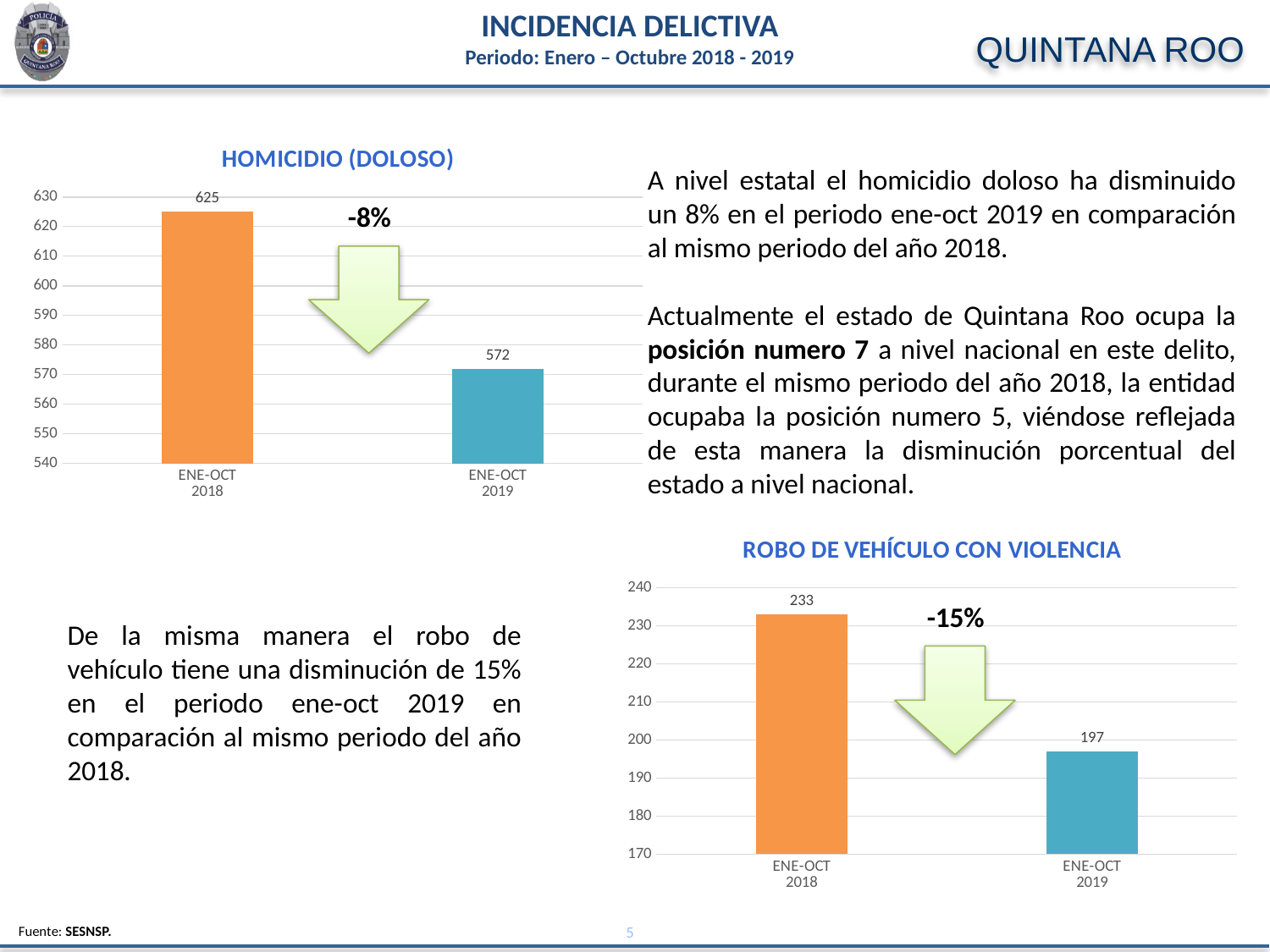
In the ROBO DE VEHÍCULO CON VIOLENCIA chart, what is the value for ENE-OCT 2019? 197 In the ROBO DE VEHÍCULO CON VIOLENCIA chart, which period has the lower value? ENE-OCT 2019 In the ROBO DE VEHÍCULO CON VIOLENCIA chart, what is the value for ENE-OCT 2018? 233 In the HOMICIDIO (DOLOSO) chart, what is the difference between the ENE-OCT 2018 and ENE-OCT 2019 values? 53 In the HOMICIDIO (DOLOSO) chart, what percentage change is shown next to the arrow? -8% In the HOMICIDIO (DOLOSO) chart, which period has the higher value? ENE-OCT 2018 In the ROBO DE VEHÍCULO CON VIOLENCIA chart, what is the difference between the ENE-OCT 2018 and ENE-OCT 2019 values? 36 How many categories are shown in the ROBO DE VEHÍCULO CON VIOLENCIA chart? 2 In the HOMICIDIO (DOLOSO) chart, what is the value for ENE-OCT 2018? 625 What kind of chart is the HOMICIDIO (DOLOSO) chart? bar chart In the ROBO DE VEHÍCULO CON VIOLENCIA chart, is the value for ENE-OCT 2019 greater or less than 200? less In the HOMICIDIO (DOLOSO) chart, what is the value for ENE-OCT 2019? 572